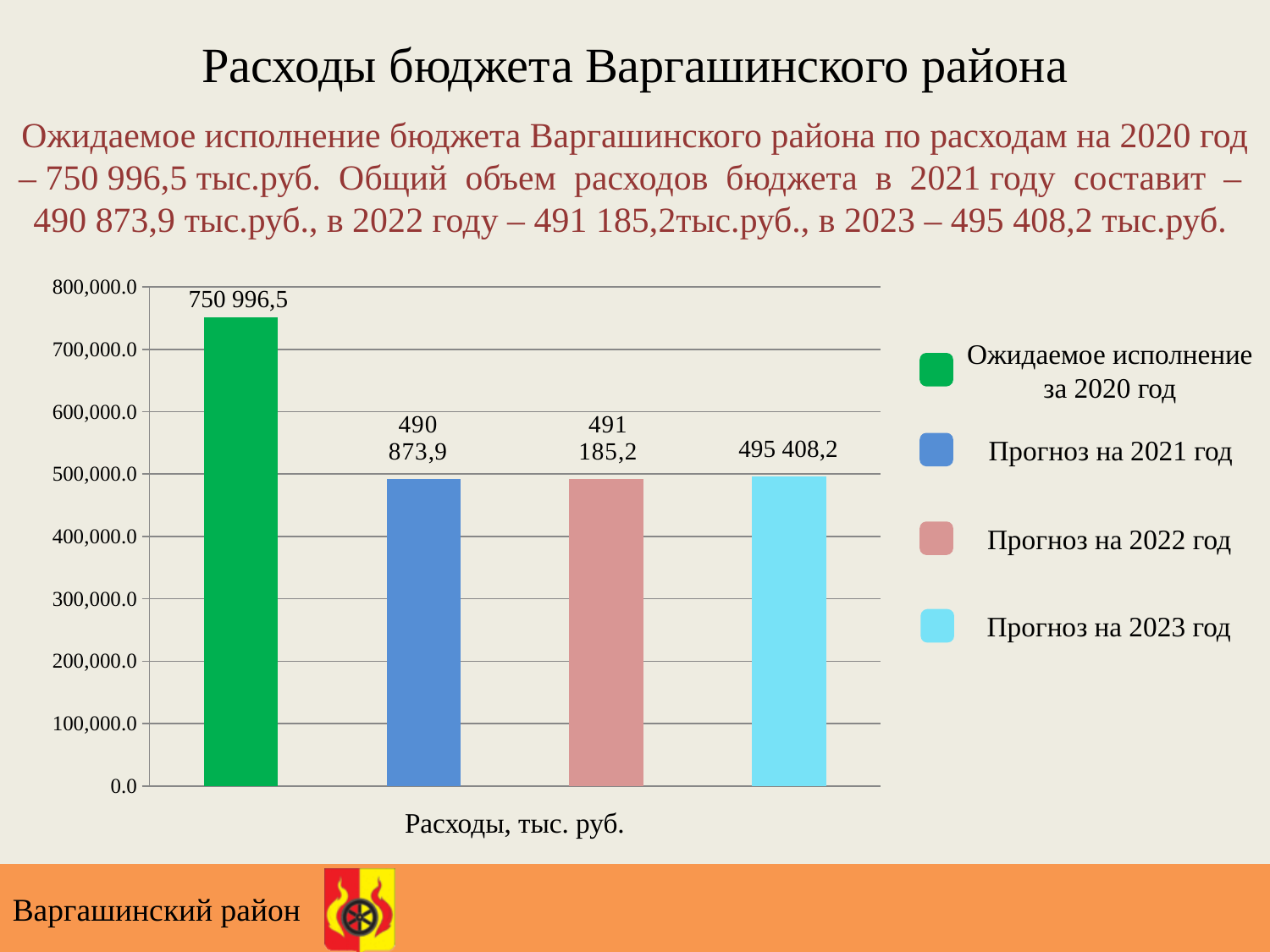
What is the value of the bar for 'Прогноз на 2021 год'? 490 873,9 Is the value for 'Прогноз на 2023 год' greater or less than 500,000.0? less What is the value of the bar for 'Прогноз на 2022 год'? 491 185,2 Which is larger: the value for 'Ожидаемое исполнение за 2020 год' or the value for 'Прогноз на 2023 год'? Ожидаемое исполнение за 2020 год How many series does the legend list? 4 What is the value of the bar for 'Прогноз на 2023 год'? 495 408,2 Which series has the highest value in the chart? Ожидаемое исполнение за 2020 год Which series has the lowest value in the chart? Прогноз на 2021 год How many bars are plotted in the chart? 4 What is the difference between the value for 2020 (750 996,5) and the value for 2021 (490 873,9)? 260 122,6 What kind of chart is shown on the slide? bar chart What is the value of the bar for 'Ожидаемое исполнение за 2020 год'? 750 996,5